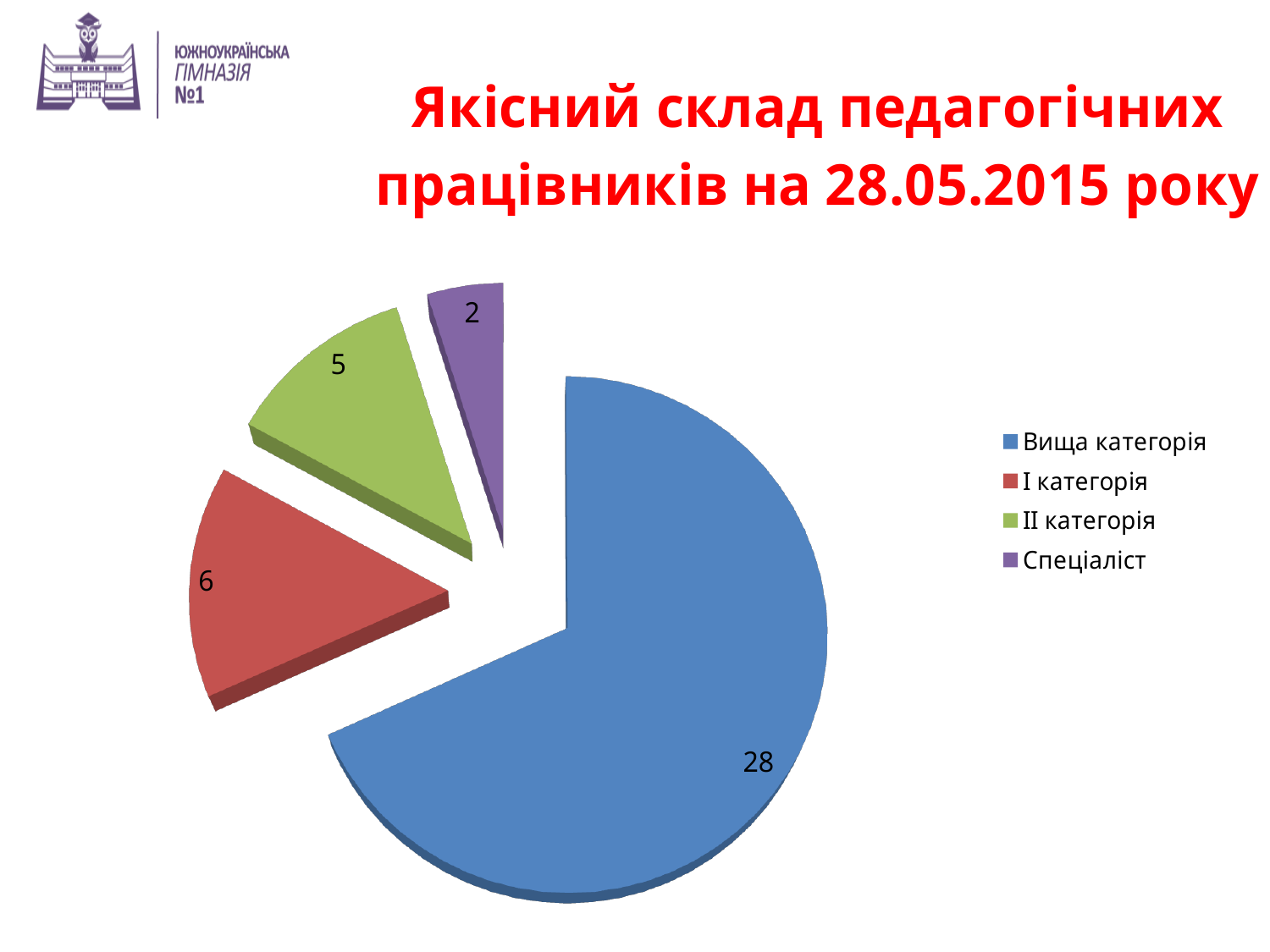
What is the difference between the values for II категорія and Спеціаліст? 3 Which category has the smallest slice of the pie? Спеціаліст Which is larger, the value for I категорія or the value for II категорія? I категорія What is the value for Спеціаліст? 2 What is the value for I категорія? 6 How many categories does the pie chart show? 4 What is the value for II категорія? 5 What is the value for Вища категорія? 28 What type of chart is shown on the slide? pie chart What is the total of all the slices in the pie chart? 41 What is the difference between the values for Вища категорія and I категорія? 22 Which category has the largest slice of the pie? Вища категорія